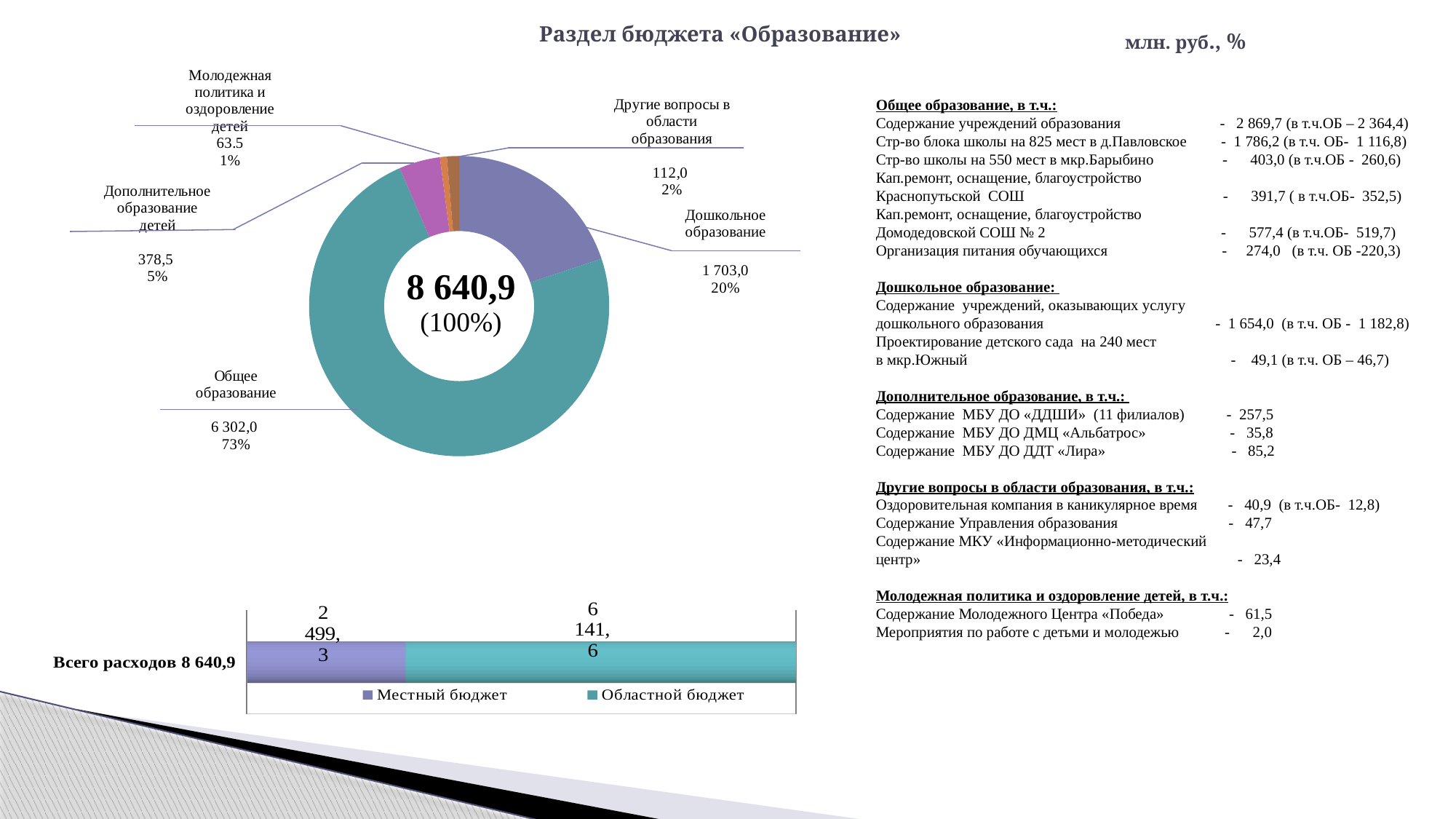
In the donut chart, what share does Дополнительное образование детей have? 5% In the donut chart, what total value is shown in the centre? 8 640,9 In the donut chart, how many categories are shown? 5 What kind of chart is shown at the bottom of the slide? Stacked bar chart In the donut chart, what is the value for Дошкольное образование? 1 703,0 In the donut chart, which category has the smallest value? Молодежная политика и оздоровление детей In the donut chart, what is the difference between Общее образование and Дошкольное образование? 4 599,0 In the bar chart at the bottom, which is larger, Местный бюджет or Областной бюджет? Областной бюджет In the donut chart, which category has the largest value? Общее образование In the bar chart at the bottom, how many series does the legend list? 2 In the donut chart, what is the value for Общее образование? 6 302,0 In the bar chart at the bottom, what is the value for Местный бюджет? 2 499,3